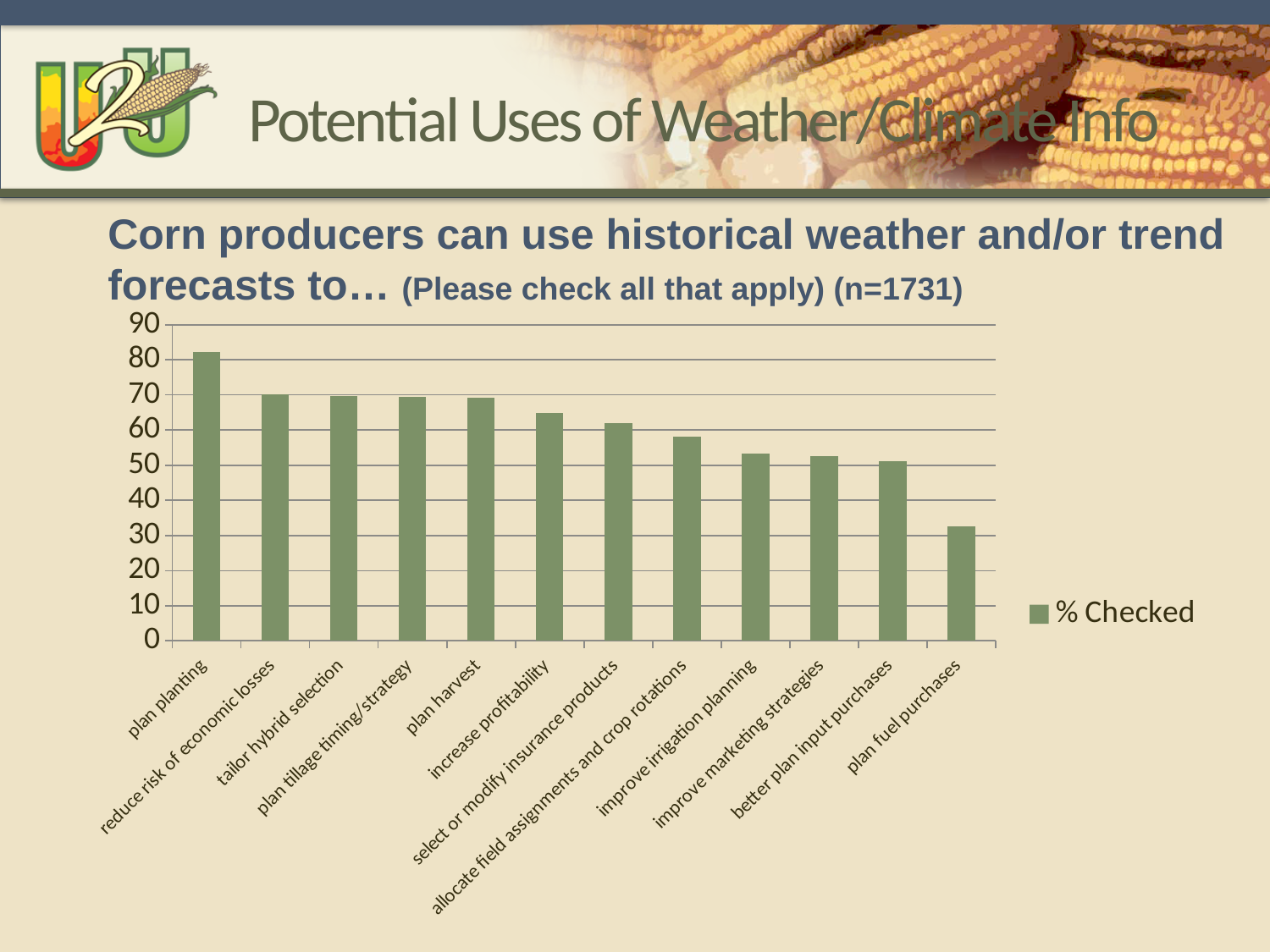
Is the value for plan fuel purchases greater or less than 40? less What kind of chart is shown on the slide? bar chart What is the name of the series shown in the legend? % Checked Which is larger, the value for improve irrigation planning or the value for plan fuel purchases? improve irrigation planning Is the value for plan planting greater or less than 70? greater Which category has the highest value? plan planting How many series does the legend list? 1 Which is larger, the value for plan harvest or the value for allocate field assignments and crop rotations? plan harvest Do the values rise or fall moving from left to right along the x axis? fall Which category has the lowest value? plan fuel purchases Is the value for increase profitability greater or less than 60? greater How many categories are plotted on the chart? 12